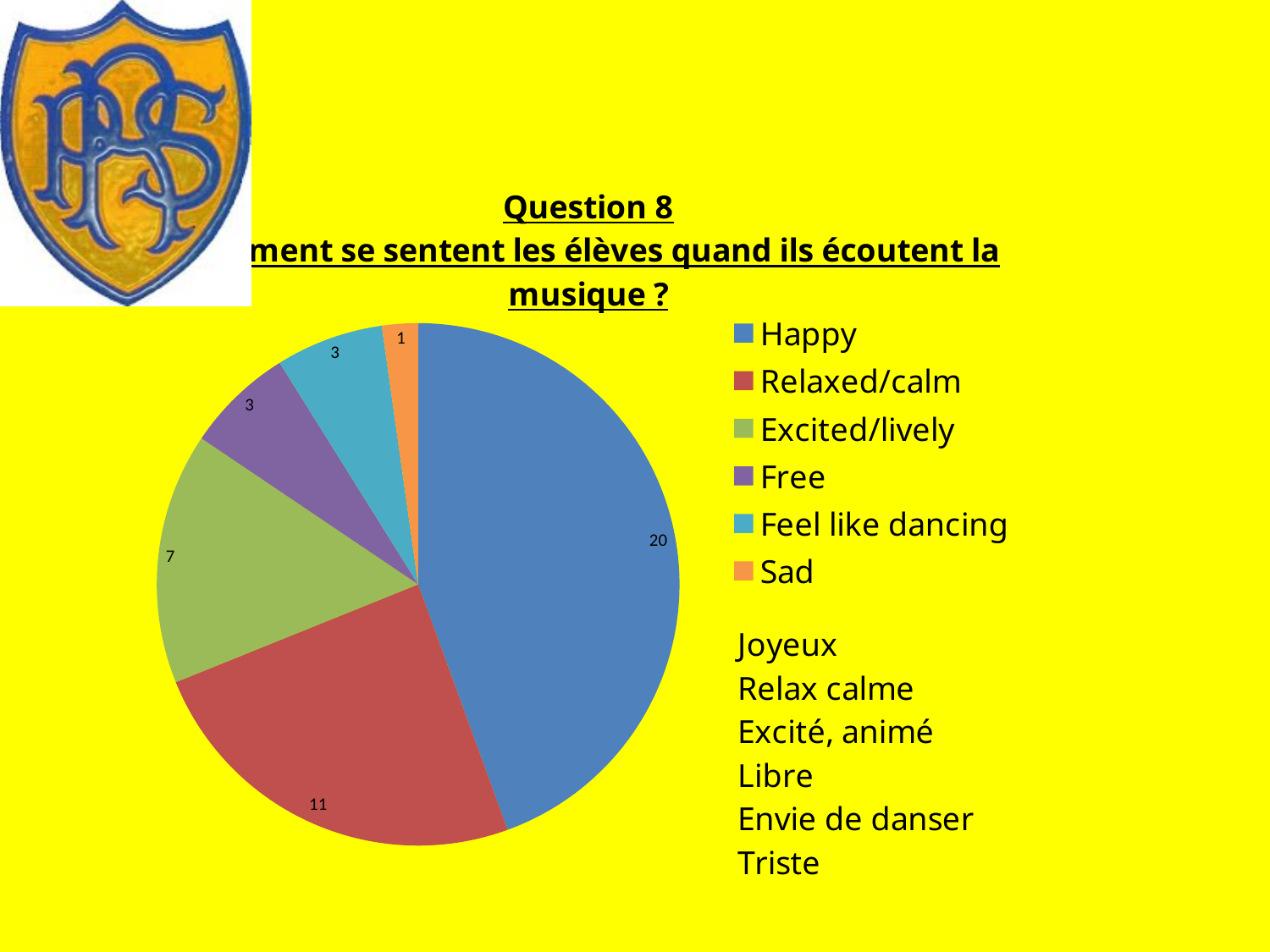
How many categories does the legend list? 6 What is the value for Excited/lively? 7 Which is larger, the value for Excited/lively or the value for Free? Excited/lively Which category has the smallest slice of the pie? Sad What is the value for Sad? 1 What is the difference between the values for Happy and Relaxed/calm? 9 What is the value for Relaxed/calm? 11 Which category has the largest slice of the pie? Happy How many students answered Happy? 20 What kind of chart is shown on the slide? pie chart What colour is the Feel like dancing slice? light blue What is the total of all the values in the pie chart? 45